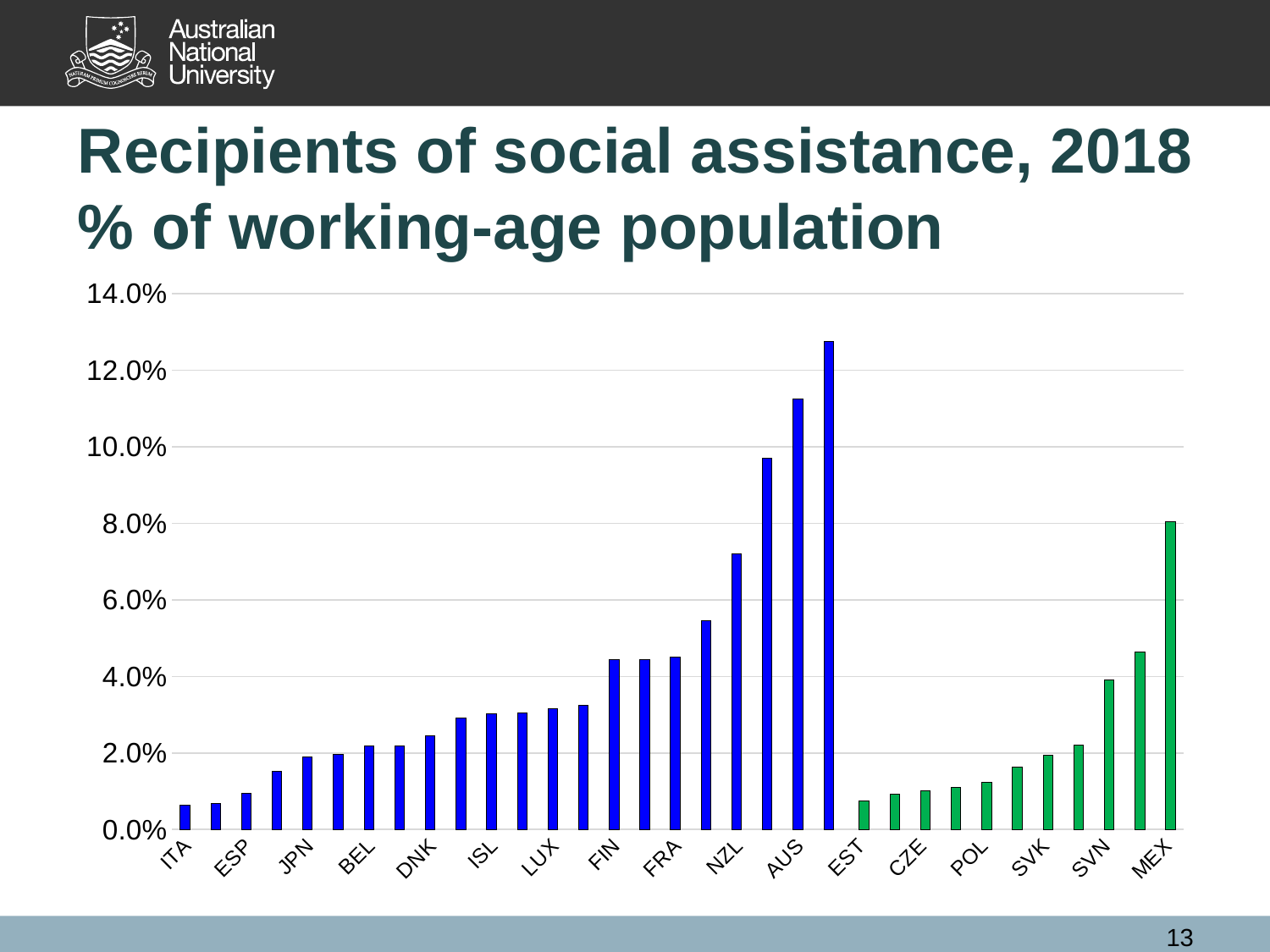
What is the title of the chart? Recipients of social assistance, 2018 % of working-age population Is the value for MEX greater or less than 6.0%? greater Is the value for ITA greater or less than 2.0%? less Is the value for DNK greater or less than 2.0%? greater Which has the larger value, AUS or MEX? AUS What two colours are used for the bars in the chart? blue and green Do the green bars rise or fall from EST to MEX? rise What kind of chart is shown on the slide? bar chart Which has the larger value, NZL or FRA? NZL